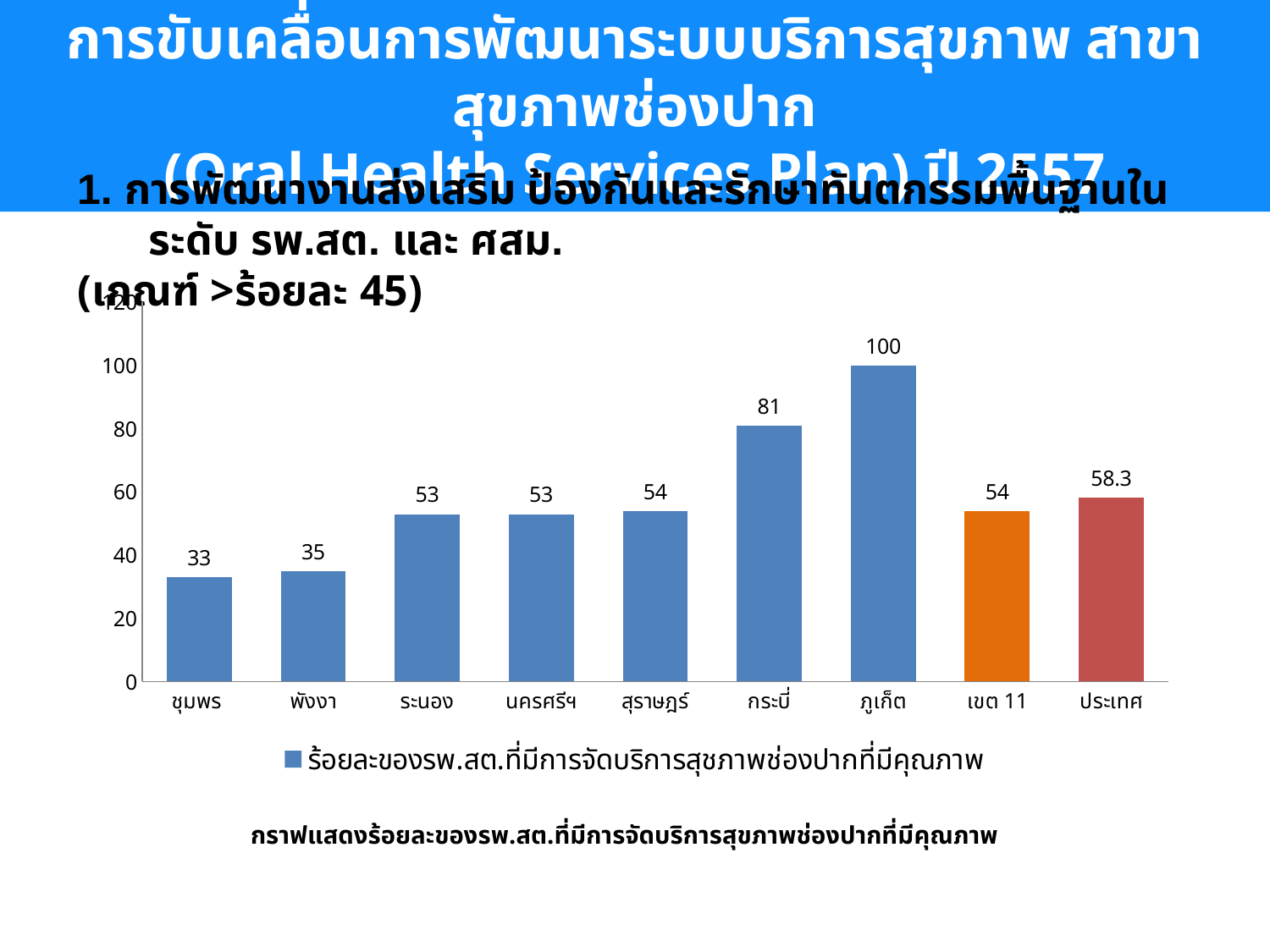
What is the difference between the values for ภูเก็ต and กระบี่? 19 What is the value for ประเทศ? 58.3 How many categories are shown on the x axis? 9 What kind of chart is shown on the slide? bar chart How many series does the legend list? 1 What is the value for ชุมพร? 33 What is the value for กระบี่? 81 Which category has the lowest value? ชุมพร What is the value for ภูเก็ต? 100 Which category has the highest value? ภูเก็ต Which is larger, the value for พังงา or the value for ระนอง? ระนอง Is the value for เขต 11 greater or less than 40? greater